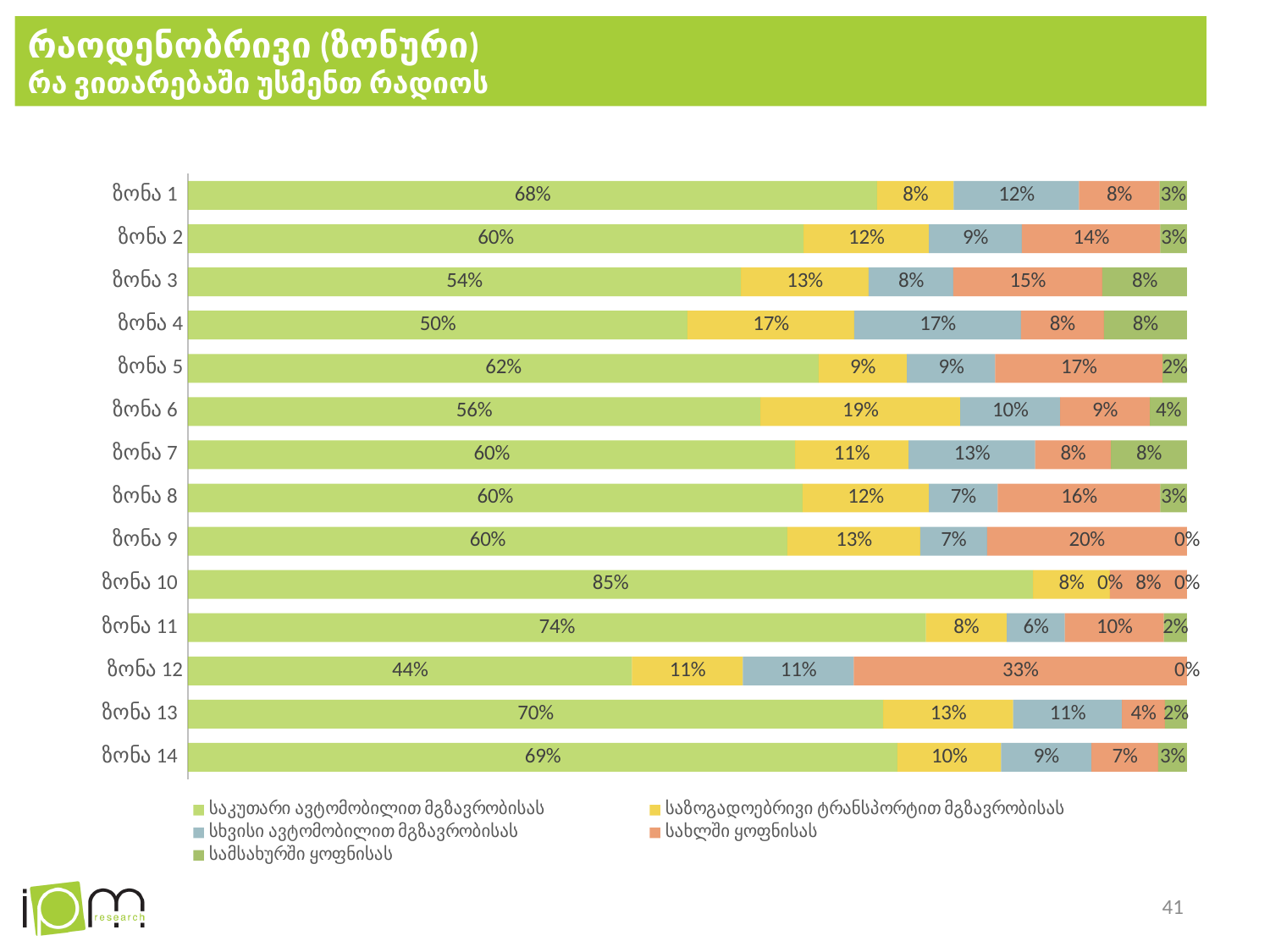
What is the value for ზონა 6 in the საზოგადოებრივი ტრანსპორტით მგზავრობისას series? 19% How many zones (categories) are shown on the chart? 14 Which zone has the lowest value in the საკუთარი ავტომობილით მგზავრობისას series? ზონა 12 What is the difference between the საკუთარი ავტომობილით მგზავრობისას values for ზონა 10 and ზონა 12? 41% Which is larger: the სახლში ყოფნისას value for ზონა 9 or for ზონა 13? ზონა 9 Which series is shown in orange in the legend? სახლში ყოფნისას What kind of chart is shown on the slide? Stacked bar chart What is the value for ზონა 12 in the სახლში ყოფნისას series? 33% What is the value for ზონა 4 in the სხვისი ავტომობილით მგზავრობისას series? 17% How many series does the legend list? 5 Which zone has the highest value in the საკუთარი ავტომობილით მგზავრობისას series? ზონა 10 What is the value for ზონა 10 in the საკუთარი ავტომობილით მგზავრობისას series? 85%